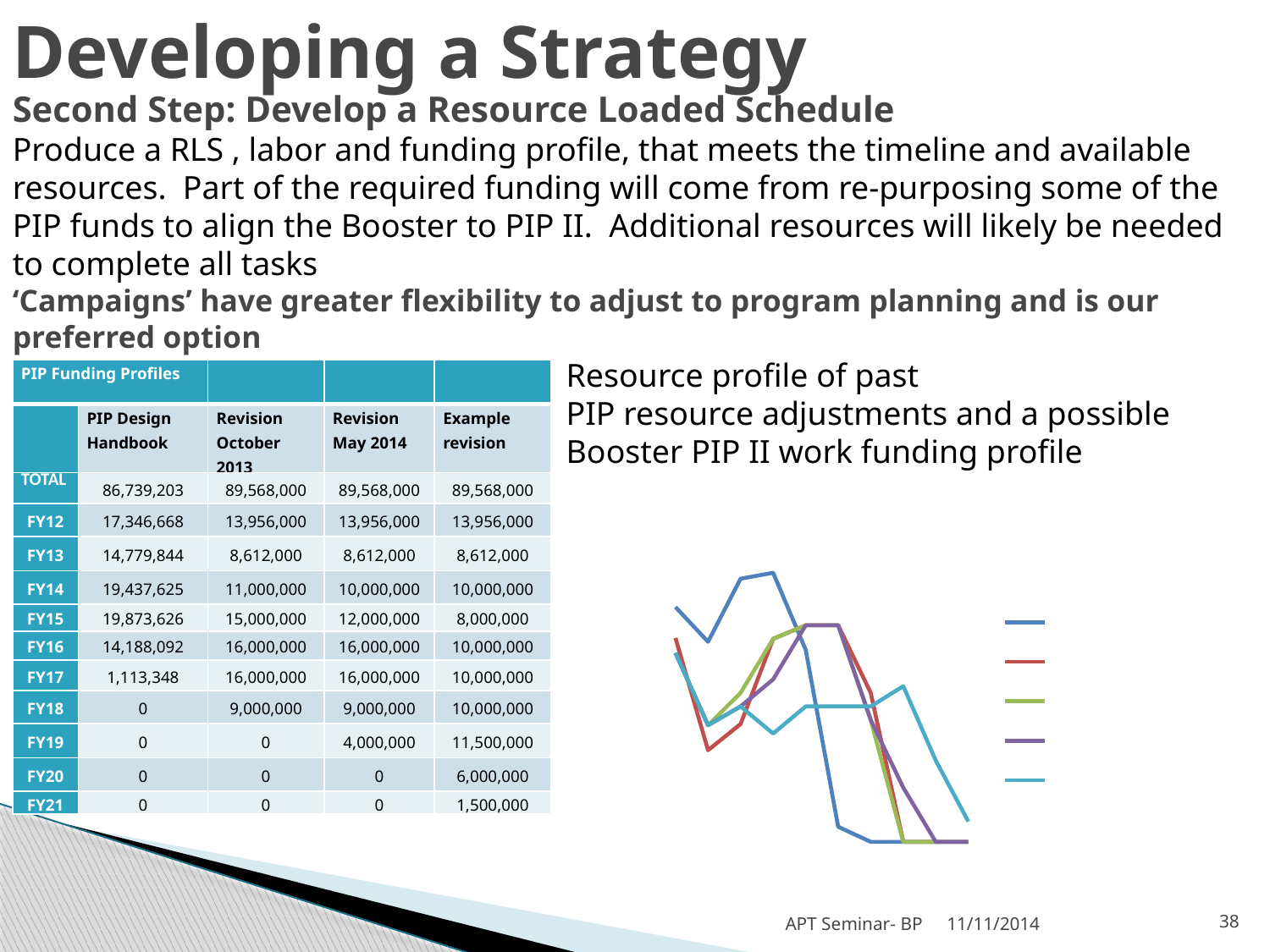
What colour is the first entry in the chart's legend? blue What kind of chart is shown on the right side of the slide? line chart What colour is the last entry in the chart's legend? teal Overall, do the values of the blue line in the chart rise or fall from left to right? fall Overall, do the values of the purple line in the chart rise or fall from left to right? fall How many series does the legend of the line chart list? 5